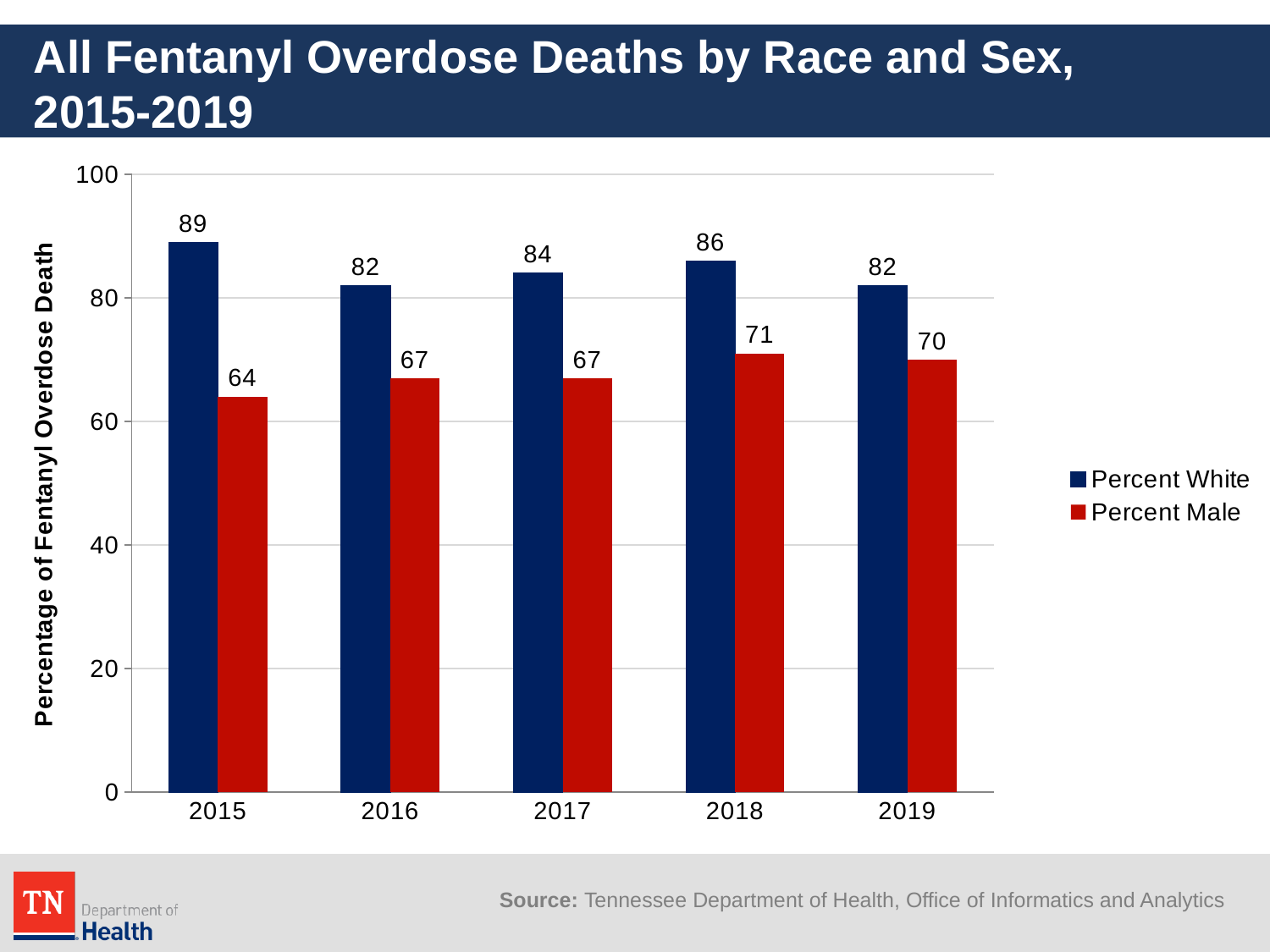
What is the Percent Male value for 2018? 71 What is the difference between the Percent Male values for 2018 and 2016? 4 What kind of chart is shown on the slide? Bar chart What is the difference between Percent White and Percent Male in 2015? 25 How many years are shown on the x axis? 5 What is the Percent Male value for 2019? 70 Which year has the lowest Percent Male value? 2015 How many series does the legend list? 2 What is the label of the y axis? Percentage of Fentanyl Overdose Death Which year has the highest Percent White value? 2015 What is the Percent White value for 2015? 89 Which is larger, the Percent White value for 2017 or for 2019? 2017